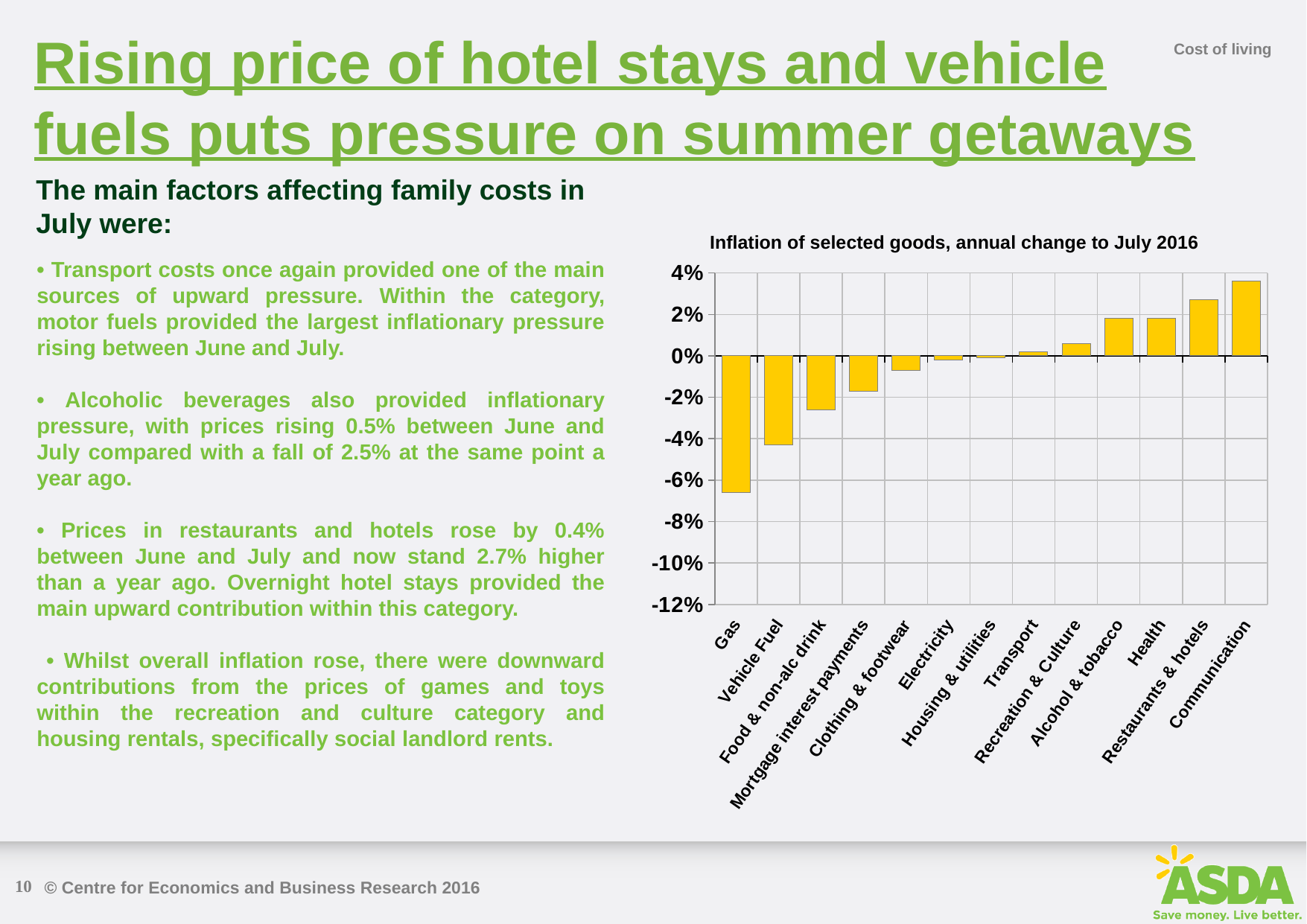
Which is larger, the value for Mortgage interest payments or the value for Clothing & footwear? Clothing & footwear Is the value for Gas greater or less than -6%? less Which category has the lowest annual inflation in the chart? Gas Is the value for Communication greater or less than 2%? greater How many categories are plotted in the chart? 13 Which category has the highest annual inflation in the chart? Communication What is the title of the chart? Inflation of selected goods, annual change to July 2016 Which is larger, the value for Restaurants & hotels or the value for Health? Restaurants & hotels Do the values generally rise or fall moving from left to right along the x axis? rise Is the value for Food & non-alc drink greater or less than -2%? less What kind of chart is shown on the slide? bar chart